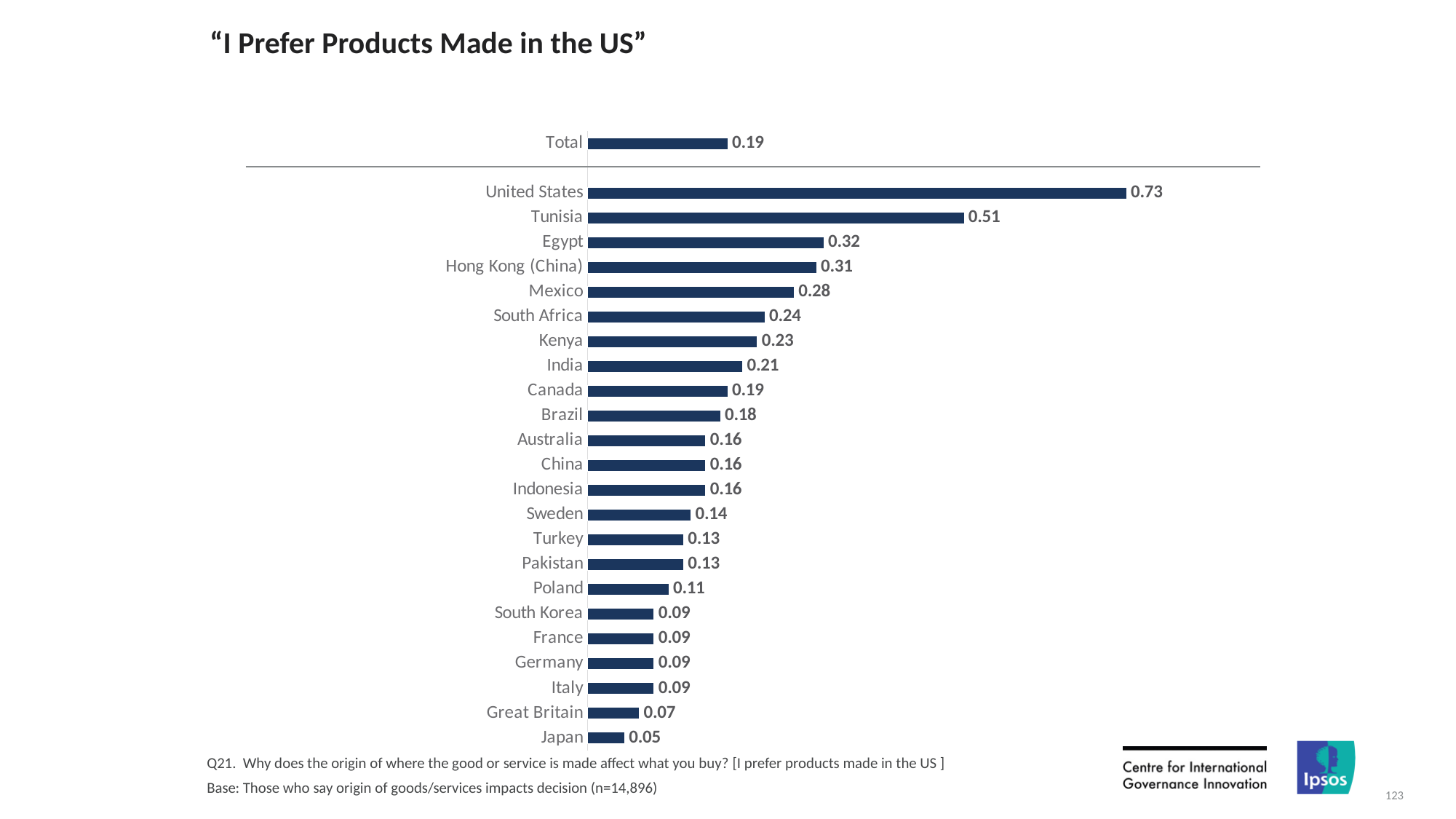
What is the value for the United States? 0.73 Which country has the highest value? United States What is the value for Japan? 0.05 How many countries are listed below the Total bar? 23 What kind of chart is shown on the slide? Bar chart What is the value for Total? 0.19 What is the difference between the values for Egypt and Mexico? 0.04 What is the difference between the values for the United States and Tunisia? 0.22 What is the value for Tunisia? 0.51 Which has a larger value, Hong Kong (China) or South Africa? Hong Kong (China) What is the title of the chart? "I Prefer Products Made in the US" Which country has the lowest value? Japan